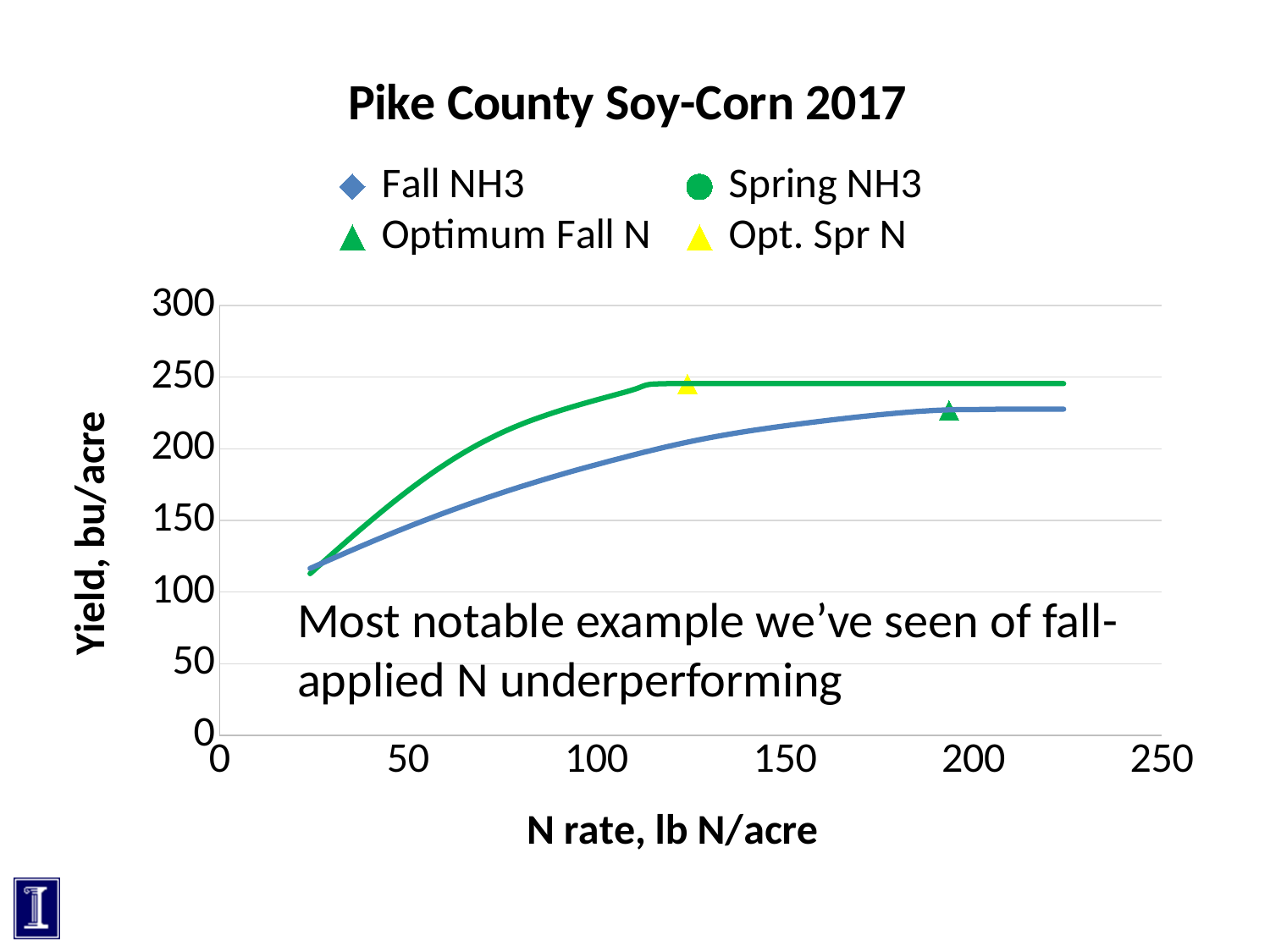
Is the Spring NH3 yield at an N rate of 100 lb N/acre greater or less than 200? greater Is the Fall NH3 yield at an N rate of 100 lb N/acre greater or less than 200? less Which optimum marker is at the higher N rate, Optimum Fall N or Opt. Spr N? Optimum Fall N At an N rate of 100 lb N/acre, which series has the higher yield, Fall NH3 or Spring NH3? Spring NH3 Does the Fall NH3 yield rise or fall as the N rate increases from 25 to 200 lb N/acre? rise What kind of chart is shown on the slide? line chart Is the N rate of the Optimum Fall N marker greater or less than 150 lb N/acre? greater What is the title of the chart? Pike County Soy-Corn 2017 How many series does the legend list? 4 What is the label of the y axis? Yield, bu/acre